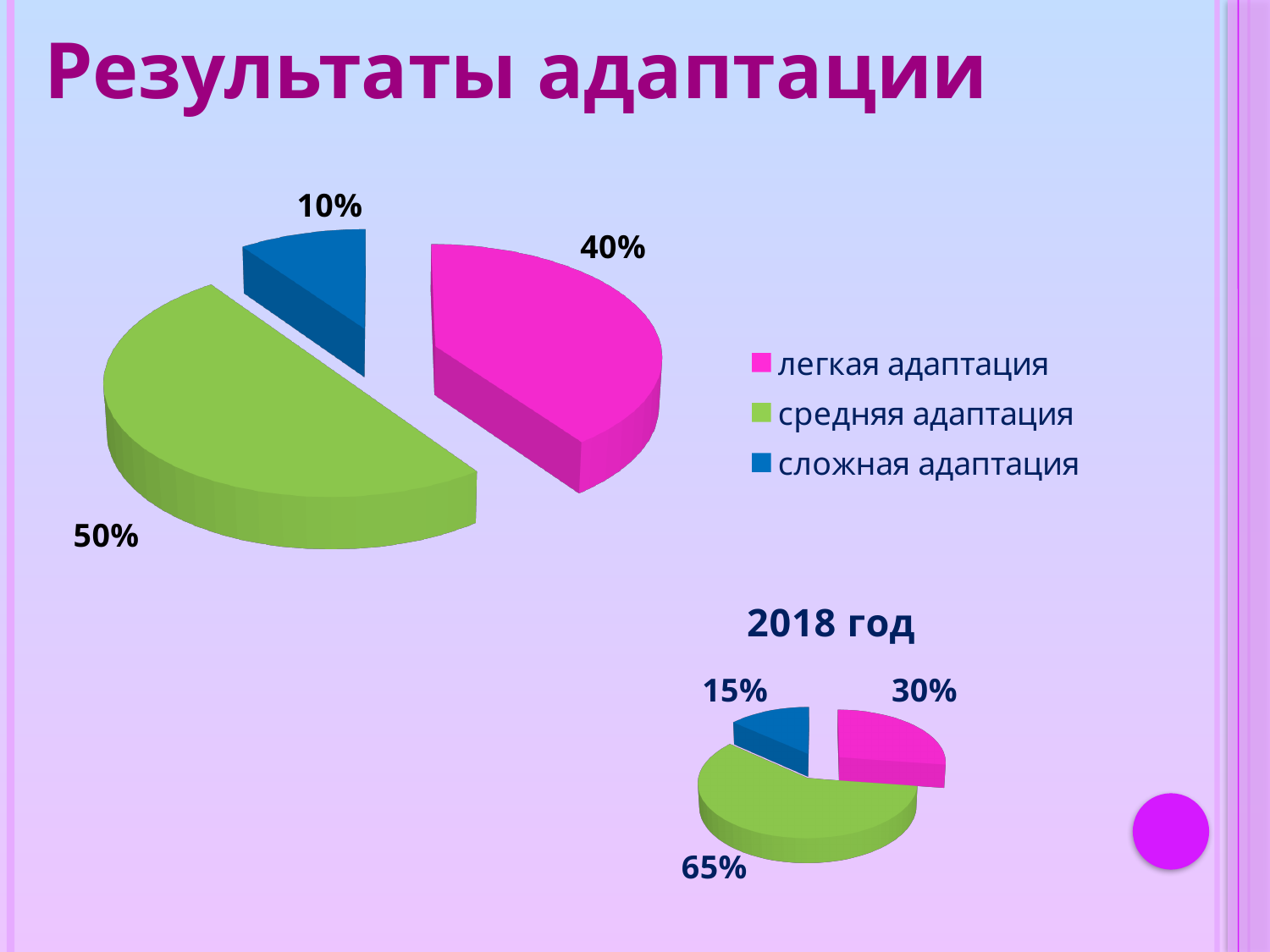
In the large pie chart on the left, what is the difference between the shares for легкая адаптация and сложная адаптация? 30% In the large pie chart on the left, which category has the largest slice? средняя адаптация In the large pie chart on the left, what share is labelled for легкая адаптация (pink slice)? 40% In the small pie chart titled '2018 год', what share is labelled for легкая адаптация (pink slice)? 30% In the small pie chart titled '2018 год', what share is labelled for средняя адаптация (green slice)? 65% In the large pie chart on the left, what share is labelled for средняя адаптация (green slice)? 50% In the small pie chart titled '2018 год', which is larger: the share for легкая адаптация or the share for сложная адаптация? легкая адаптация In the large pie chart on the left, what share is labelled for сложная адаптация (blue slice)? 10% In the small pie chart titled '2018 год', which category has the smallest slice? сложная адаптация How many categories does the legend list for the pie charts? 3 What is the title of the small chart in the bottom right? 2018 год What type of chart is the large chart on the left? Pie chart